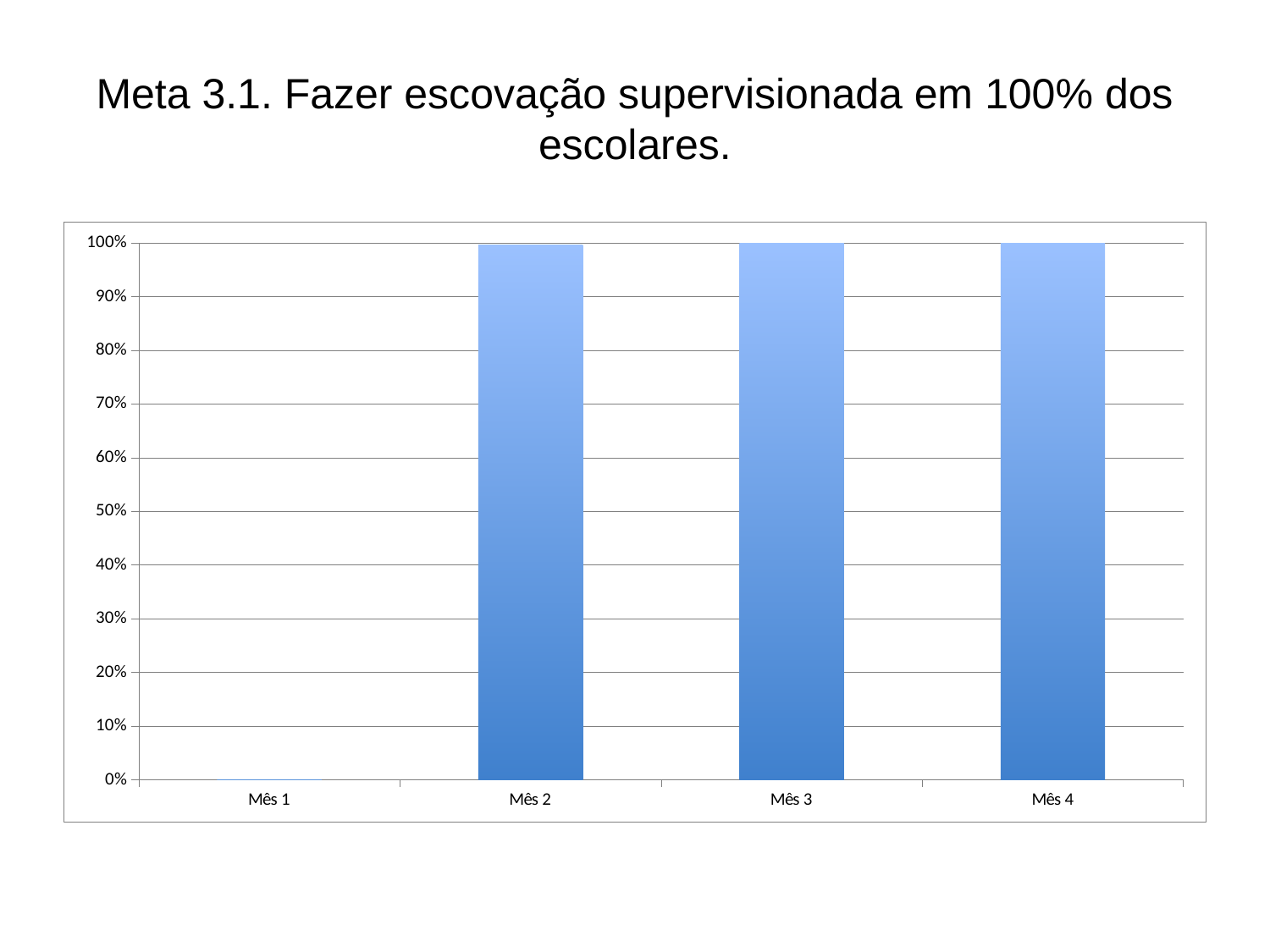
Is the value for Mês 1 greater or less than 10%? less Which is larger, the value for Mês 1 or the value for Mês 2? Mês 2 What is the label of the first category on the x axis? Mês 1 What is the value for Mês 1? 0% What is the value for Mês 4? 100% What kind of chart is shown on the slide? bar chart Which category has the lowest value? Mês 1 What is the difference between the value for Mês 4 and the value for Mês 1? 100% How many categories are shown on the x axis of the chart? 4 Is the value for Mês 3 greater or less than 50%? greater What is the value for Mês 3? 100%